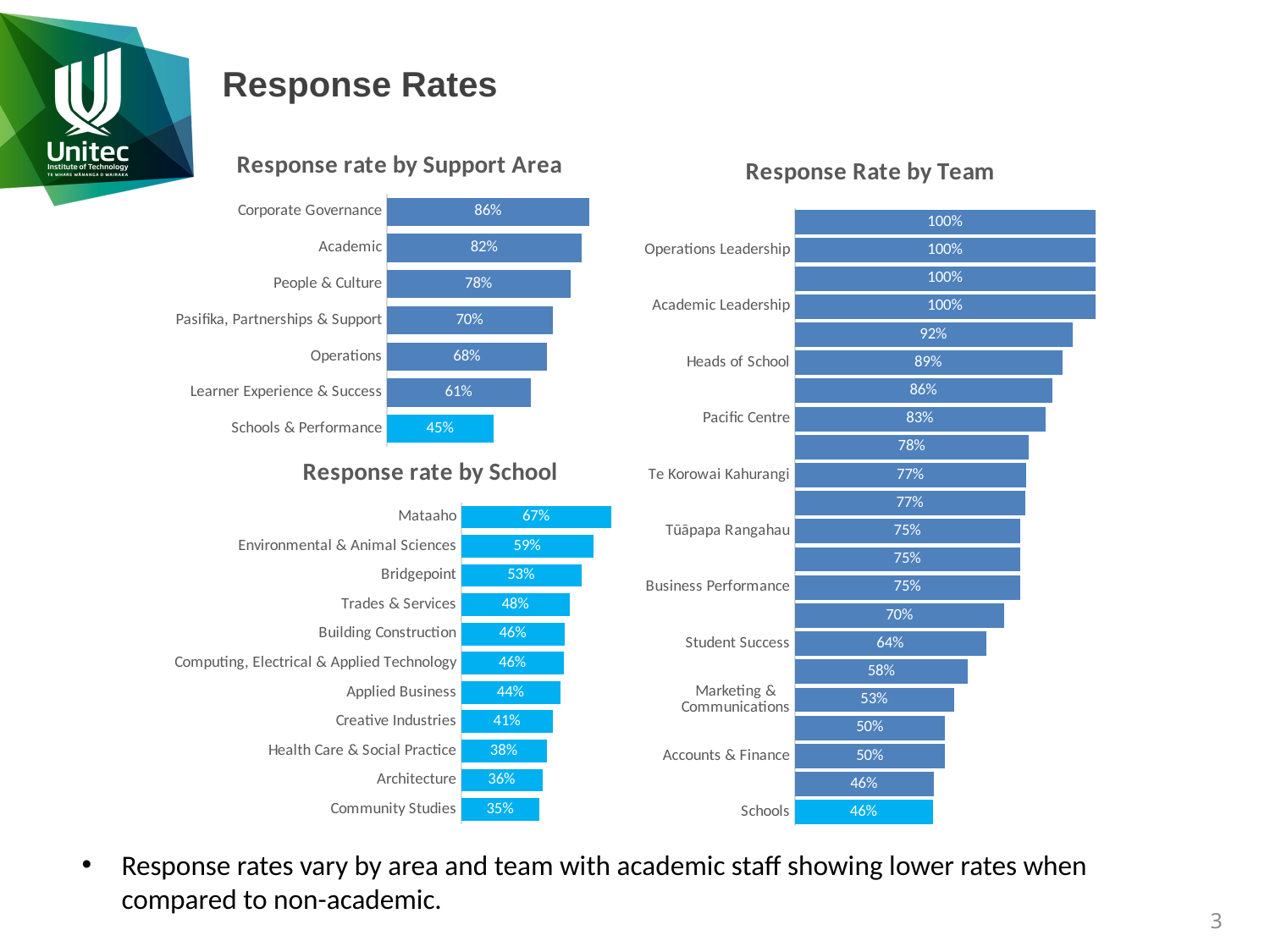
In the 'Response Rate by Team' chart, what is the response rate for Student Success? 64% What type of chart is the 'Response Rate by Team' chart? Bar chart How many schools are listed in the 'Response rate by School' chart? 11 In the 'Response rate by Support Area' chart, which support area has the lowest response rate? Schools & Performance In the 'Response rate by School' chart, which school has the highest response rate? Mataaho In the 'Response Rate by Team' chart, what is the difference between the response rates for Pacific Centre and Schools? 37% How many support areas are shown in the 'Response rate by Support Area' chart? 7 In the 'Response Rate by Team' chart, what is the response rate for Heads of School? 89% In the 'Response rate by Support Area' chart, what is the difference between the response rates for Academic and Operations? 14% In the 'Response rate by Support Area' chart, what is the response rate for Corporate Governance? 86% In the 'Response rate by School' chart, which has a higher response rate, Applied Business or Architecture? Applied Business In the 'Response rate by School' chart, what is the response rate for Bridgepoint? 53%